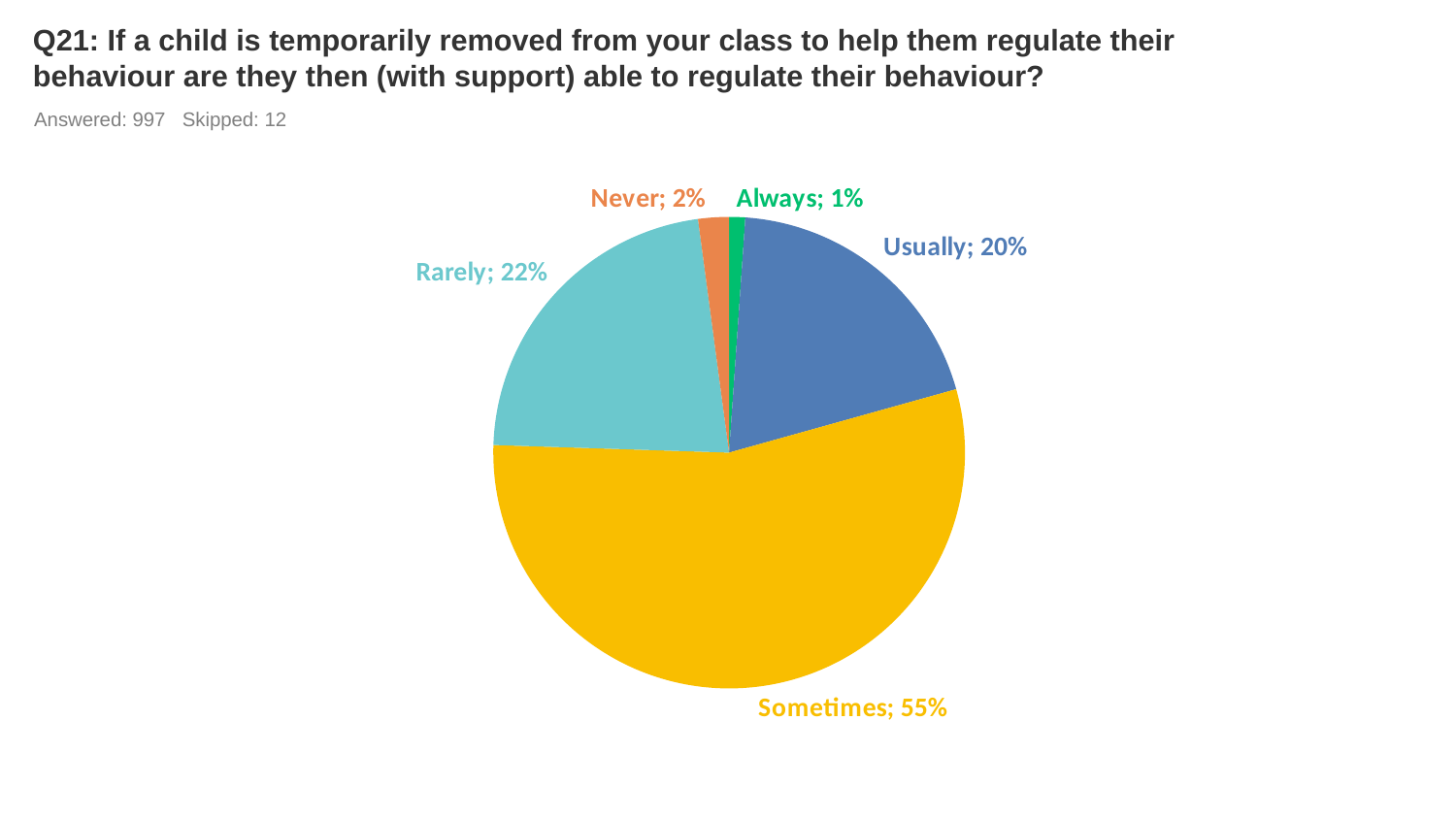
What kind of chart is shown on the slide? Pie chart What percentage of respondents answered "Never"? 2% Which is larger, the share for "Rarely" or the share for "Usually"? Rarely How many respondents answered this question according to the slide? 997 What is the difference in percentage points between "Sometimes" and "Rarely"? 33 What is the combined share of "Usually" and "Always"? 21% How many response categories are shown in the pie chart? 5 What percentage of respondents answered "Sometimes"? 55% Which response has the largest share of the pie? Sometimes What percentage of respondents answered "Usually"? 20% What percentage of respondents answered "Rarely"? 22% Which response has the smallest share of the pie? Always